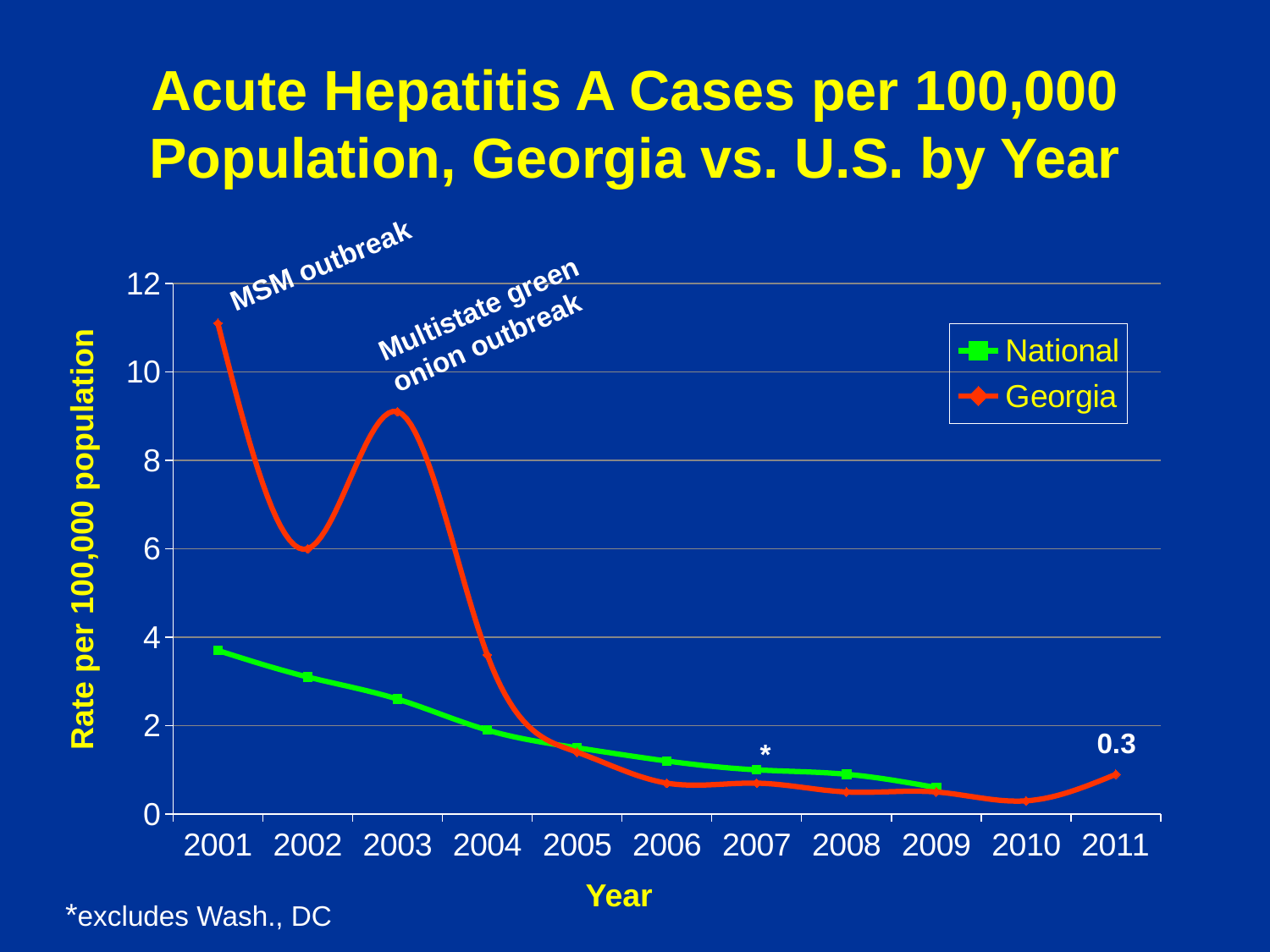
In which year is the Georgia rate highest? 2001 Is the Georgia rate in 2003 greater or less than 8? greater In which year is the Georgia rate lowest? 2010 Is the Georgia rate in 2001 greater or less than 10? greater How many years are shown on the x axis? 11 In which year is the National rate lowest? 2009 Which two series are listed in the legend? National and Georgia How many series does the legend list? 2 Is the National rate in 2001 greater or less than 4? less Which series has the higher rate in 2003, National or Georgia? Georgia What kind of chart is shown on the slide? line chart Which series has the higher rate in 2008, National or Georgia? National